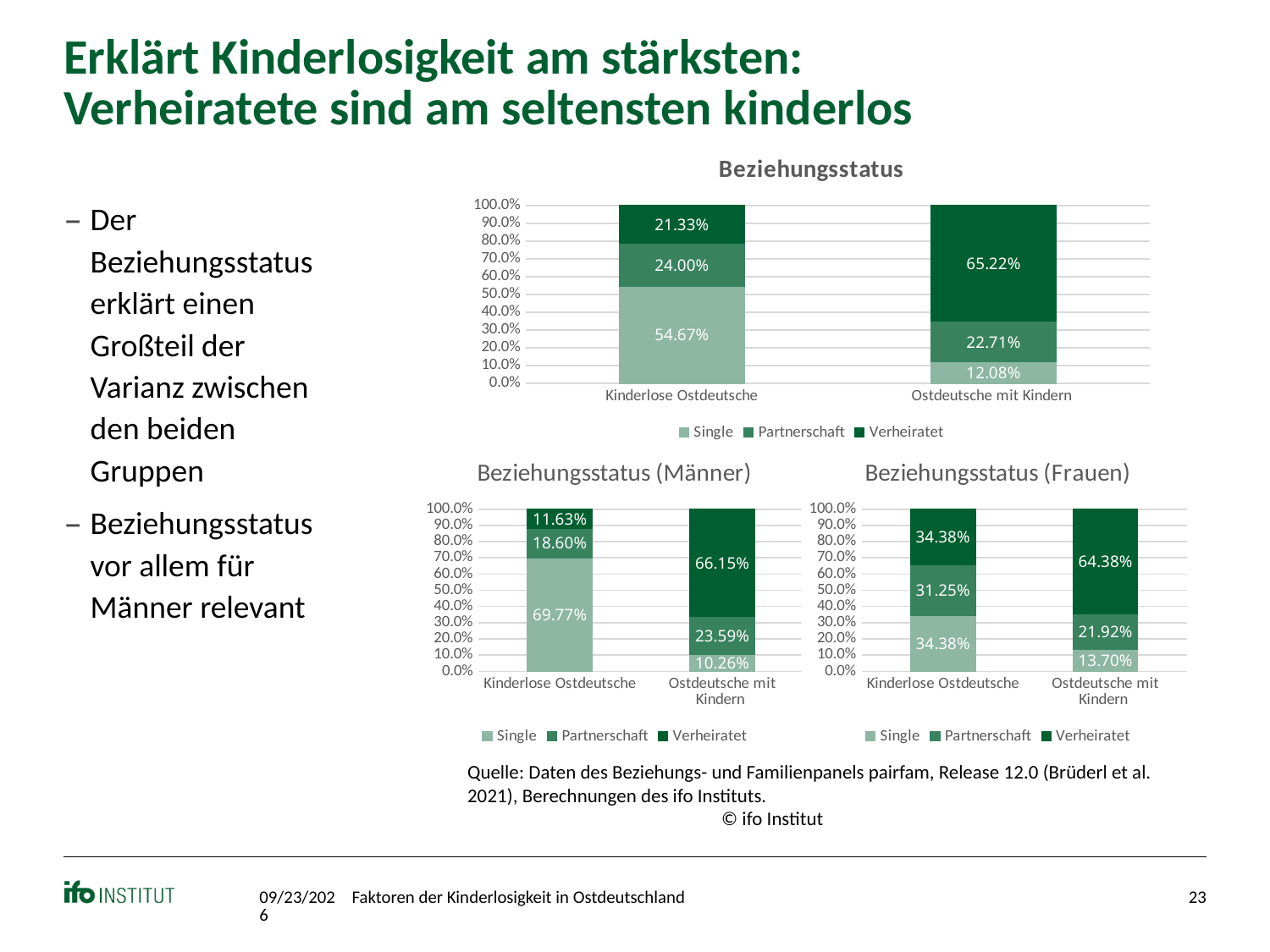
In the 'Beziehungsstatus' chart, what is the value for Single among Kinderlose Ostdeutsche? 54.67% In the 'Beziehungsstatus (Frauen)' chart, is the Verheiratet value for Kinderlose Ostdeutsche larger or smaller than the Verheiratet value for Ostdeutsche mit Kindern? smaller In the 'Beziehungsstatus' chart, what is the value for Verheiratet among Ostdeutsche mit Kindern? 65.22% In the 'Beziehungsstatus (Frauen)' chart, what is the value for Verheiratet among Ostdeutsche mit Kindern? 64.38% What kind of chart is the 'Beziehungsstatus (Frauen)' chart? Stacked bar chart In the 'Beziehungsstatus' chart, what is the difference between the Partnerschaft values for Kinderlose Ostdeutsche and Ostdeutsche mit Kindern? 1.29% In the 'Beziehungsstatus (Frauen)' chart, what is the value for Partnerschaft among Kinderlose Ostdeutsche? 31.25% In the 'Beziehungsstatus (Männer)' chart, what is the difference between the Verheiratet values for Ostdeutsche mit Kindern and Kinderlose Ostdeutsche? 54.52% How many categories are shown on the x axis of the 'Beziehungsstatus' chart? 2 In the 'Beziehungsstatus (Männer)' chart, what is the value for Single among Kinderlose Ostdeutsche? 69.77% In the 'Beziehungsstatus (Männer)' chart, which series has the lowest value for Ostdeutsche mit Kindern? Single How many series does the legend of the 'Beziehungsstatus (Männer)' chart list? 3